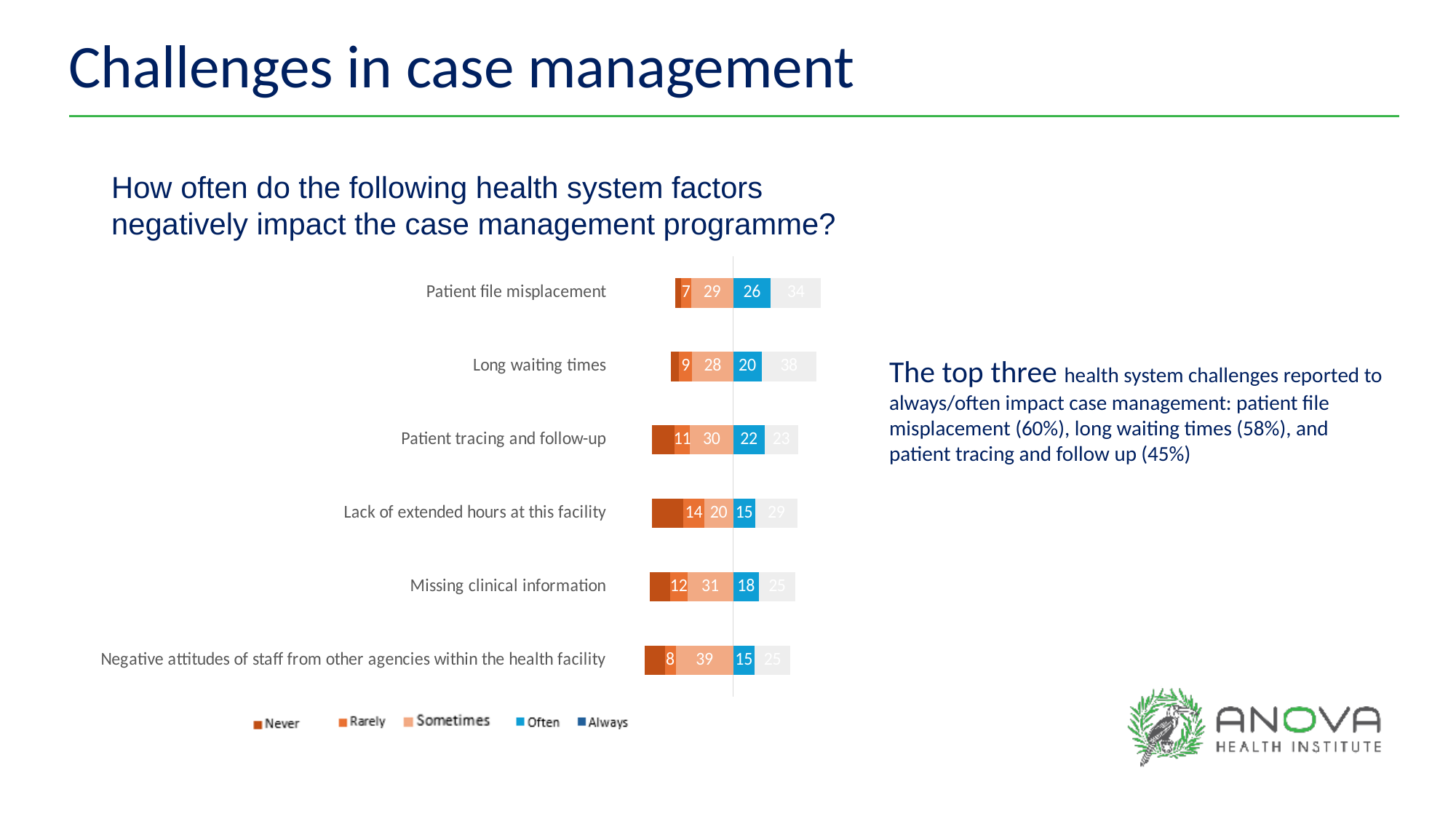
How many health system factors (categories) are plotted in the chart? 6 What is the 'Often' value for Patient tracing and follow-up? 22 Which legend entry is shown in the lightest orange colour? Sometimes Which health system factor has the lowest 'Rarely' value? Patient file misplacement What is the 'Rarely' value for Lack of extended hours at this facility? 14 How many series does the chart legend list? 5 Which health system factor has the highest 'Always' value? Long waiting times What is the 'Always' value for Long waiting times? 38 What is the difference between the 'Always' values for Patient file misplacement and Patient tracing and follow-up? 11 What is the 'Sometimes' value for Negative attitudes of staff from other agencies within the health facility? 39 What kind of chart is shown on the slide? Stacked bar chart Which is larger: the 'Often' value for Patient file misplacement or the 'Often' value for Missing clinical information? Patient file misplacement